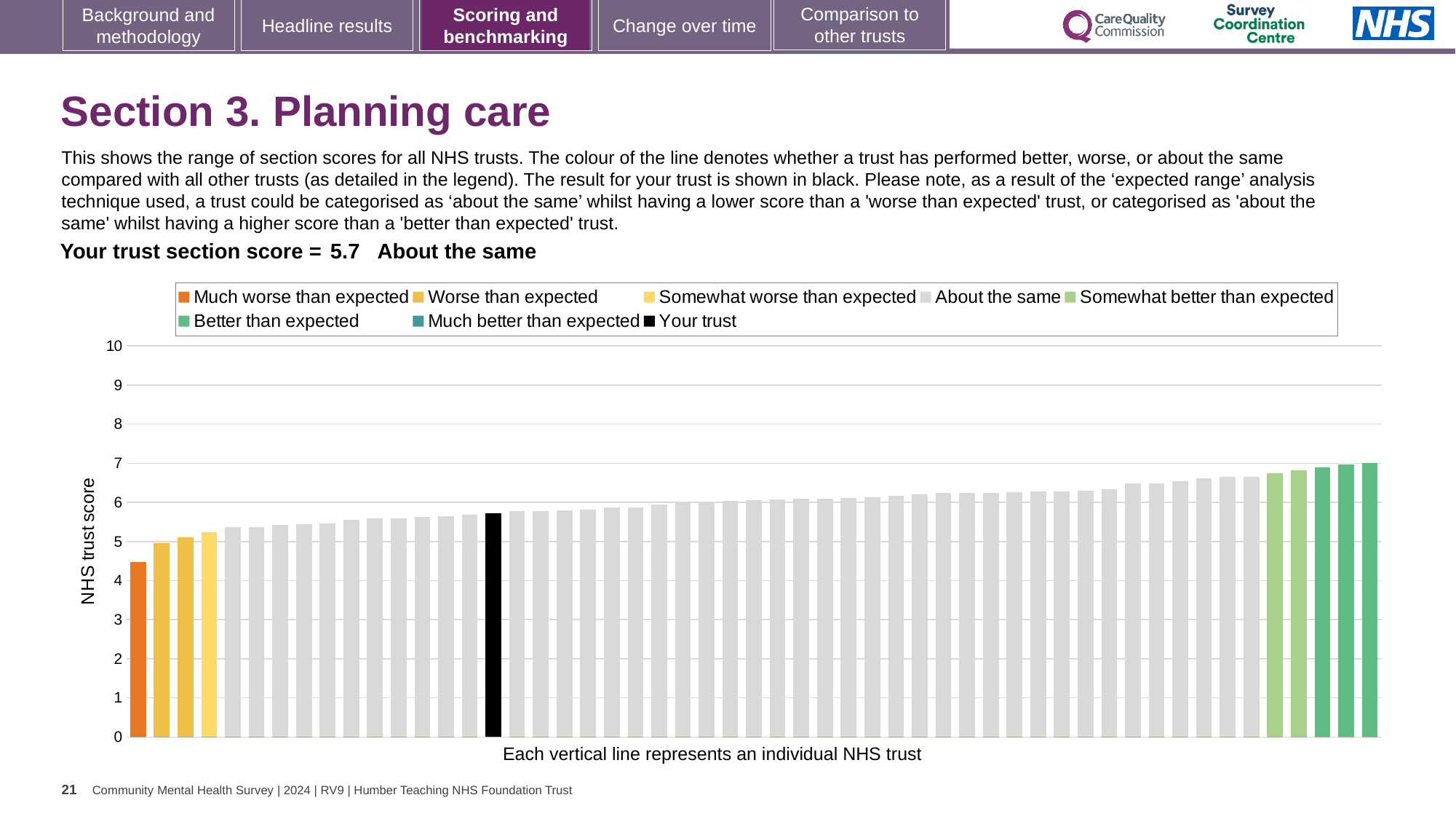
Is the value for your trust (the black bar) greater or less than 5? greater What is the section score for your trust shown on the slide? 5.7 Do the bar values rise or fall from left to right along the x axis? rise How many entries does the chart legend list? 8 Is the value for your trust (the black bar) greater or less than 6? less Is the value of the lowest bar (the orange 'Much worse than expected' trust) greater or less than 5? less How many bars are coloured orange ('Much worse than expected')? 1 What kind of chart is shown on the slide? bar chart What is the label on the vertical axis of the chart? NHS trust score What colour is the bar representing your trust? black Which performance category is your trust placed in for this section? About the same